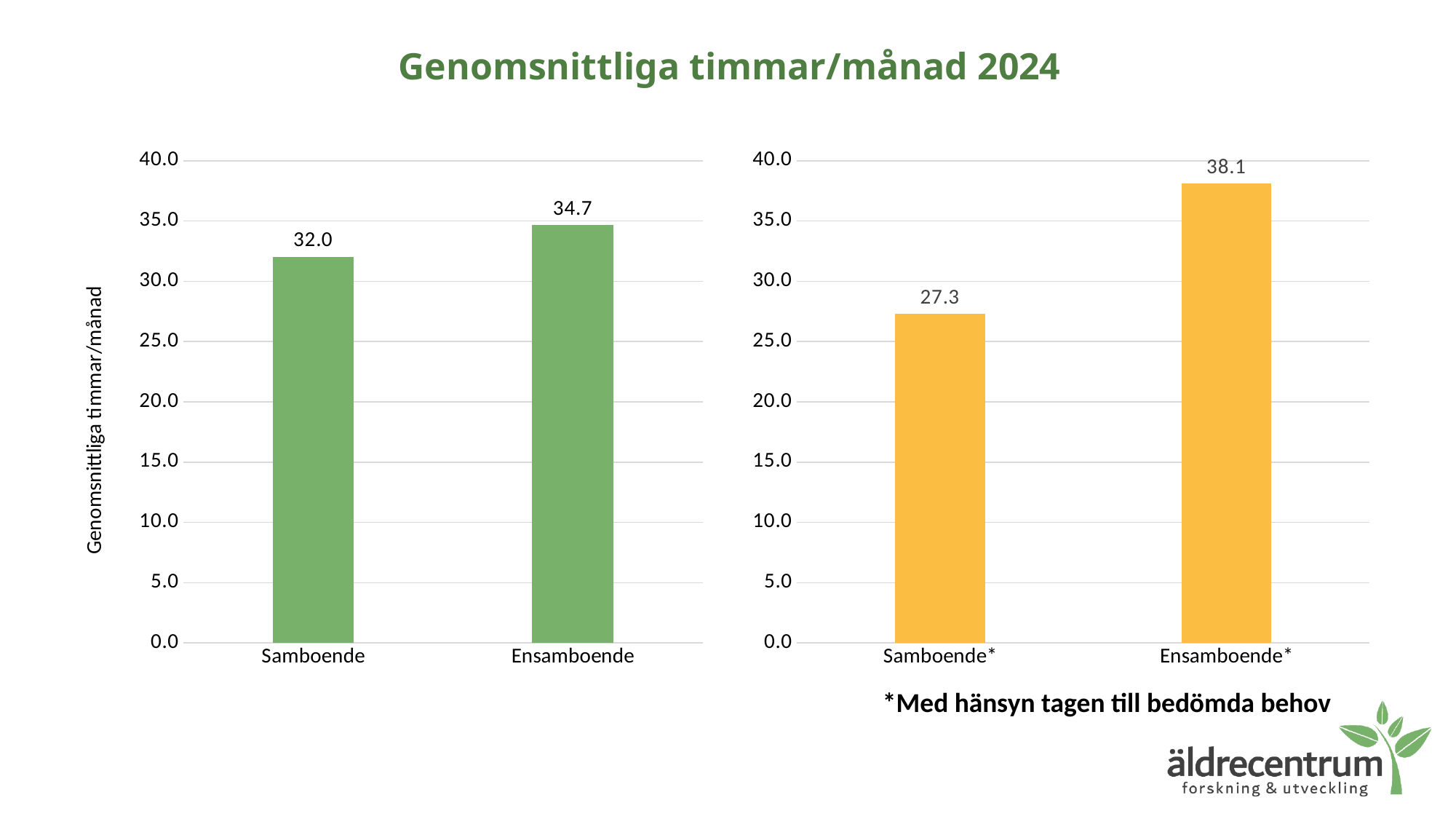
In the right chart, what is the value for Ensamboende*? 38.1 How many bars does the left chart have? 2 In the right chart, which category has the lowest value? Samboende* In the left chart, what is the value for Ensamboende? 34.7 In the right chart, what is the difference between Ensamboende* and Samboende*? 10.8 In the right chart, is the value for Ensamboende* greater or less than 35.0? greater Is the value for Samboende in the left chart larger or smaller than the value for Samboende* in the right chart? larger What type of chart is shown on the left? Bar chart In the left chart, what is the value for Samboende? 32.0 In the right chart, what is the value for Samboende*? 27.3 In the left chart, which category has the higher value? Ensamboende In the left chart, what is the difference between Ensamboende and Samboende? 2.7